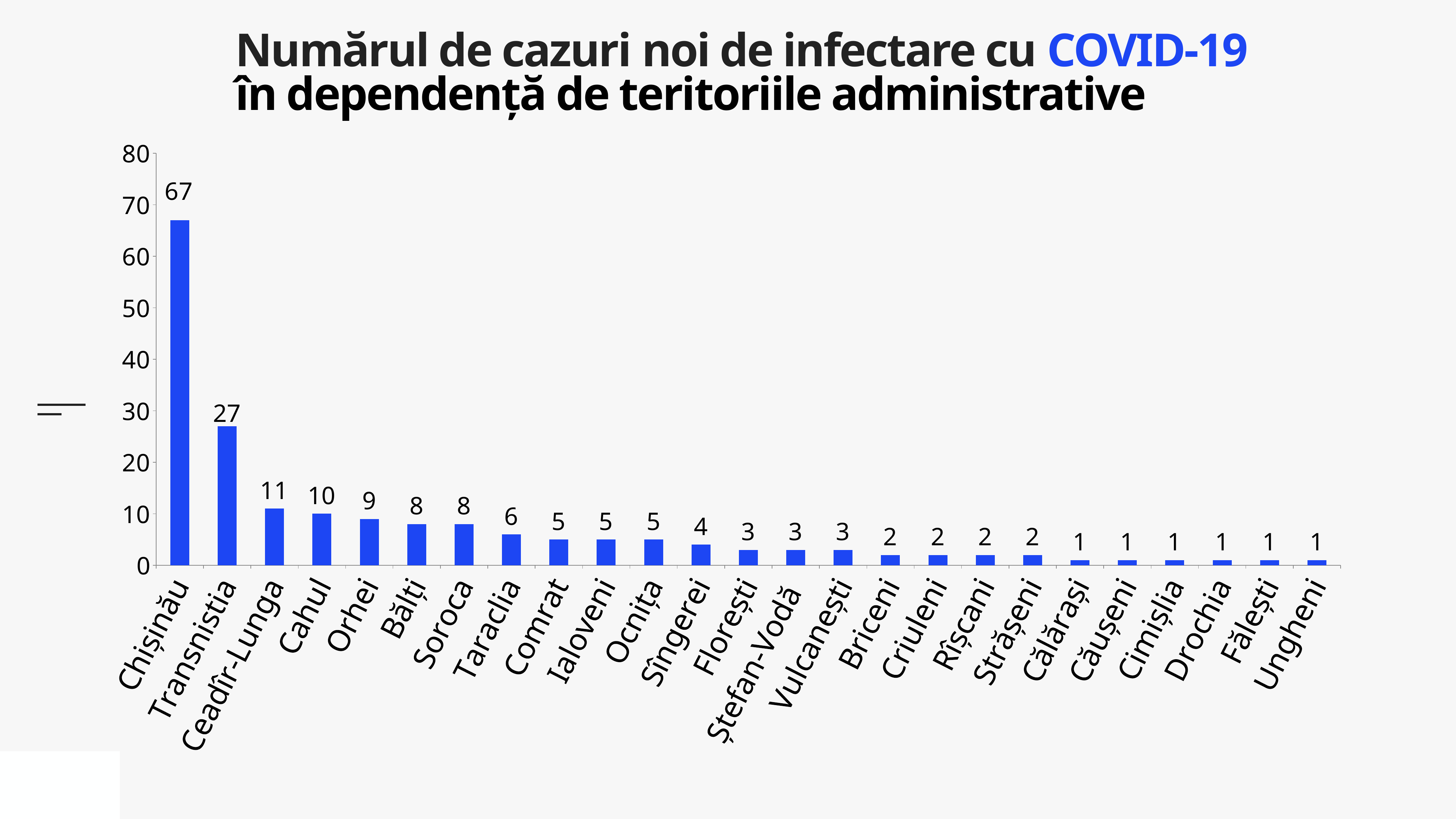
What is the difference between the values for Ceadîr-Lunga and Orhei? 2 What is the value for Transnistria? 27 Which is larger, the value for Bălți or the value for Sîngerei? Bălți Is the value for Transnistria greater or less than 30? less What is the difference between the values for Chișinău and Transnistria? 40 What is the value for Chișinău? 67 What kind of chart is shown on the slide? bar chart Which category has the highest value? Chișinău Do the values rise or fall from left to right along the x axis? fall What is the value for Taraclia? 6 How many categories are shown on the x axis? 25 What is the value for Cahul? 10